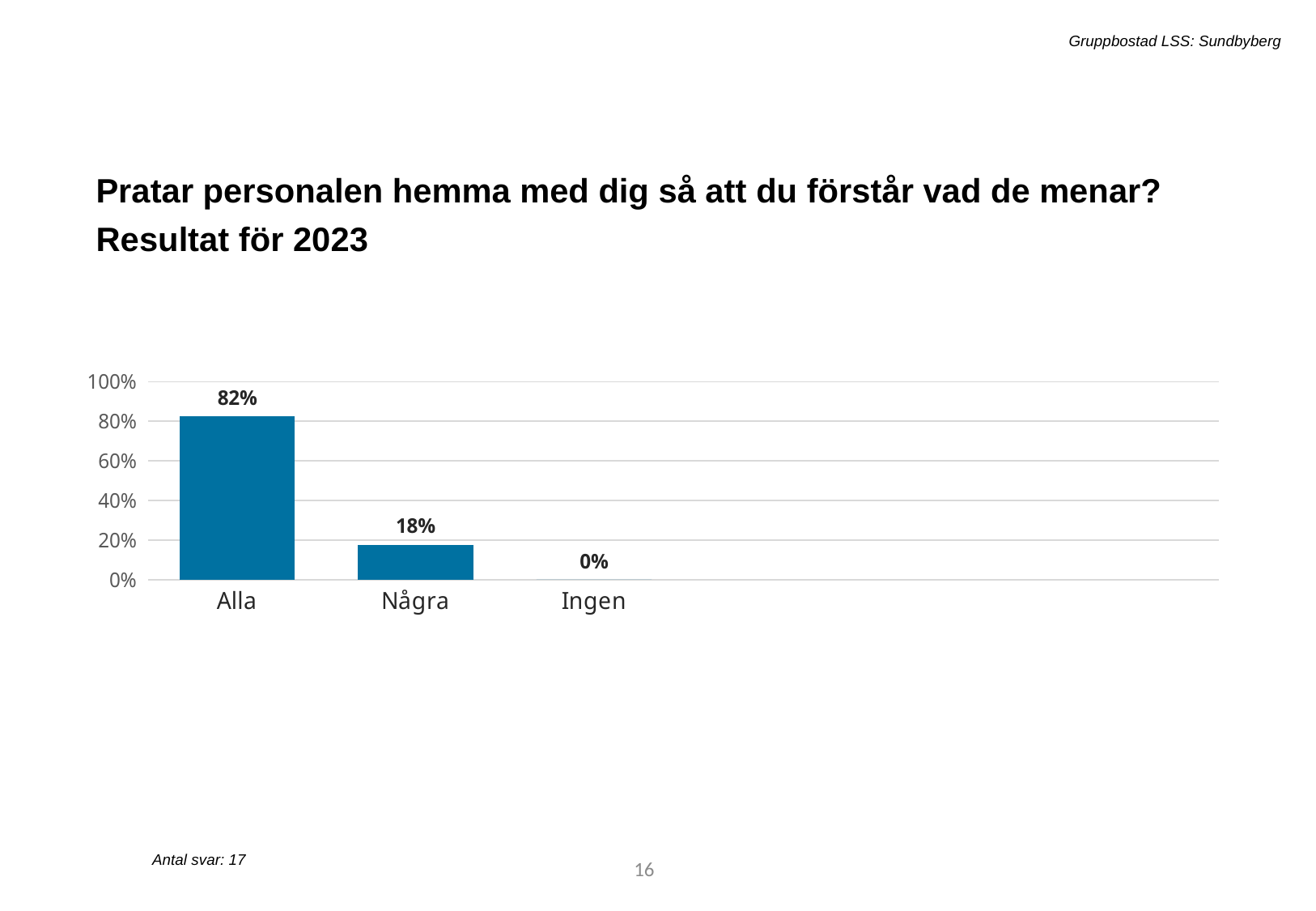
What kind of chart is shown on the slide? bar chart What is the difference between the values for Alla and Några? 64% Which is larger, the value for Några or the value for Ingen? Några What is the value for Några? 18% What is the value for Alla? 82% What is the number of responses (Antal svar) stated on the slide? 17 What is the value for Ingen? 0% Which category has the lowest value? Ingen How many categories are shown on the x axis? 3 Is the value for Alla greater or less than 60%? greater Do the values rise or fall from left to right along the x axis? fall Which category has the highest value? Alla